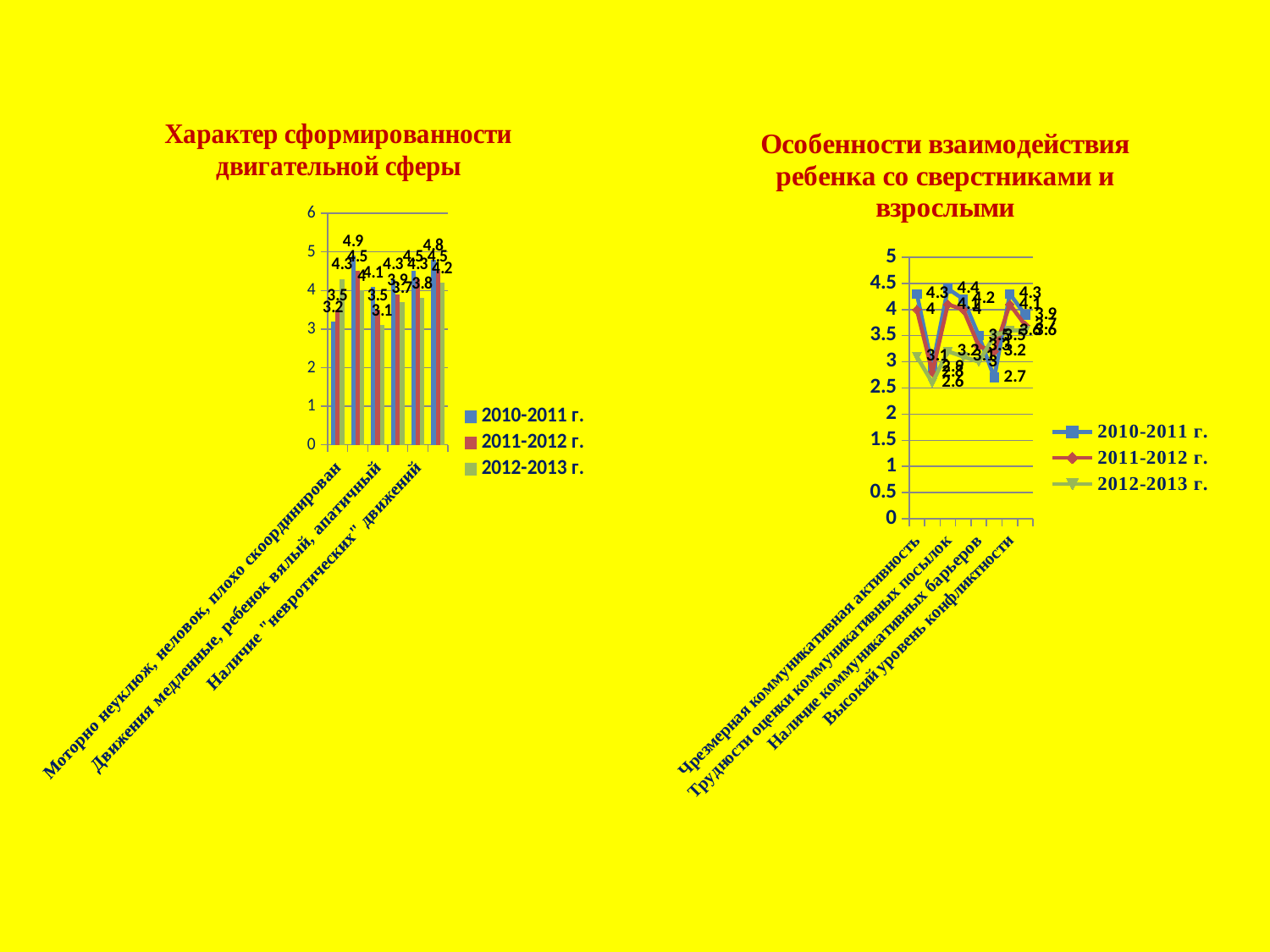
How many series does the legend of the right chart list? 3 What is the lowest data label value on the right chart? 2.6 On the right chart, is the lowest point of the 2010-2011 г. line greater or less than 3? less What are the legend entries of the right chart? 2010-2011 г., 2011-2012 г., 2012-2013 г. What is the highest data label value on the left chart? 4.9 What is the highest data label value on the right chart? 4.4 What is the highest value shown on the vertical axis of the left chart? 6 How many series does the legend of the left chart list? 3 On the left chart, is the tallest bar greater or less than 4? greater What is the lowest data label value on the left chart? 3.1 What kind of chart is the left chart, 'Характер сформированности двигательной сферы'? bar chart What kind of chart is the right chart, 'Особенности взаимодействия ребенка со сверстниками и взрослыми'? line chart